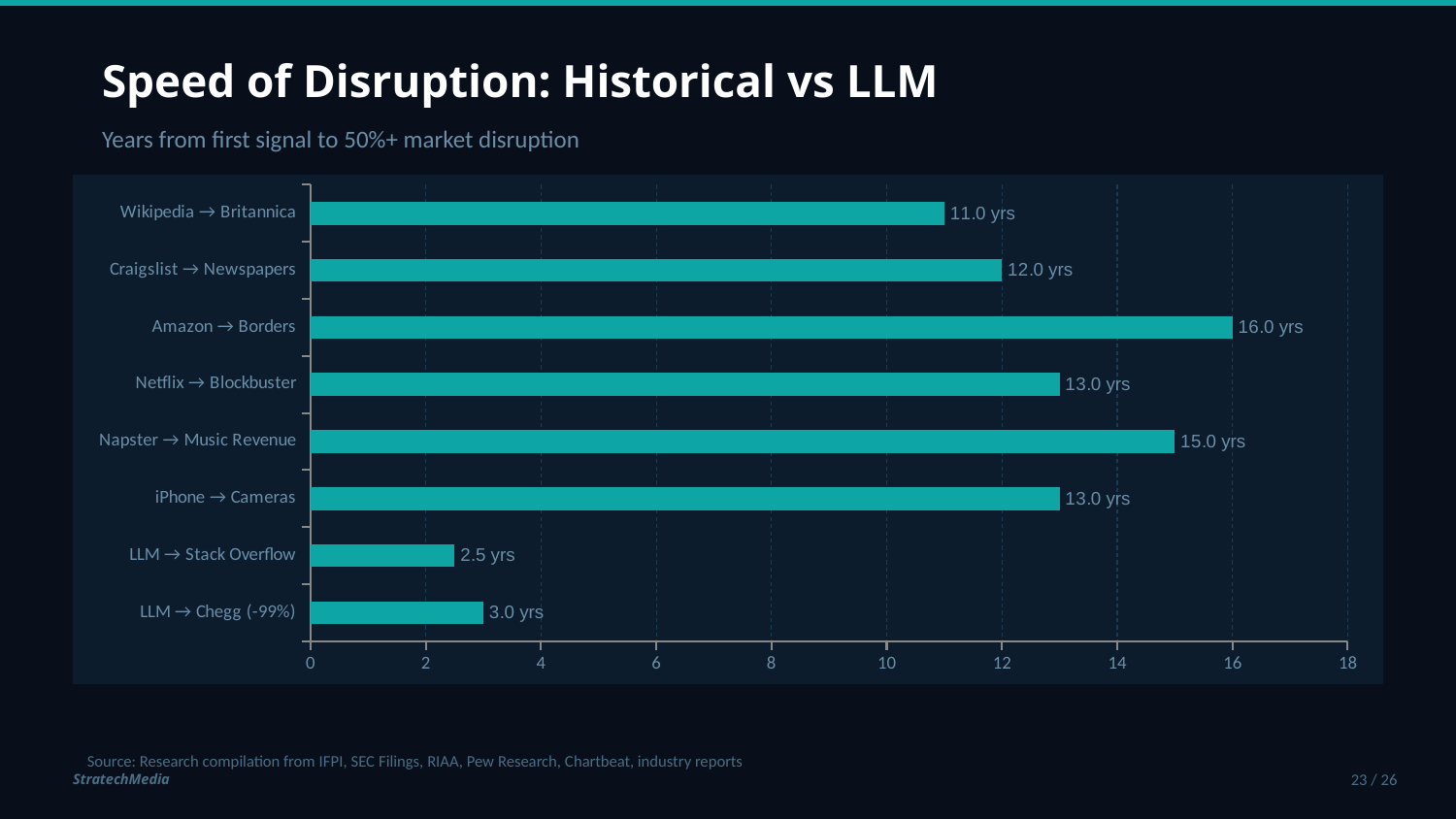
Which category has the lowest value? LLM → Stack Overflow Is the value for Netflix → Blockbuster greater or less than 12? greater What is the difference between Napster → Music Revenue and iPhone → Cameras? 2.0 yrs What kind of chart is shown on the slide? Bar chart Which is larger, Craigslist → Newspapers or Wikipedia → Britannica? Craigslist → Newspapers What is the value for Napster → Music Revenue? 15.0 yrs What is the difference between Amazon → Borders and LLM → Chegg (-99%)? 13.0 yrs What is the value for LLM → Stack Overflow? 2.5 yrs What is the title of the chart? Speed of Disruption: Historical vs LLM How many categories are shown in the chart? 8 Which category has the highest value? Amazon → Borders What is the value for Amazon → Borders? 16.0 yrs